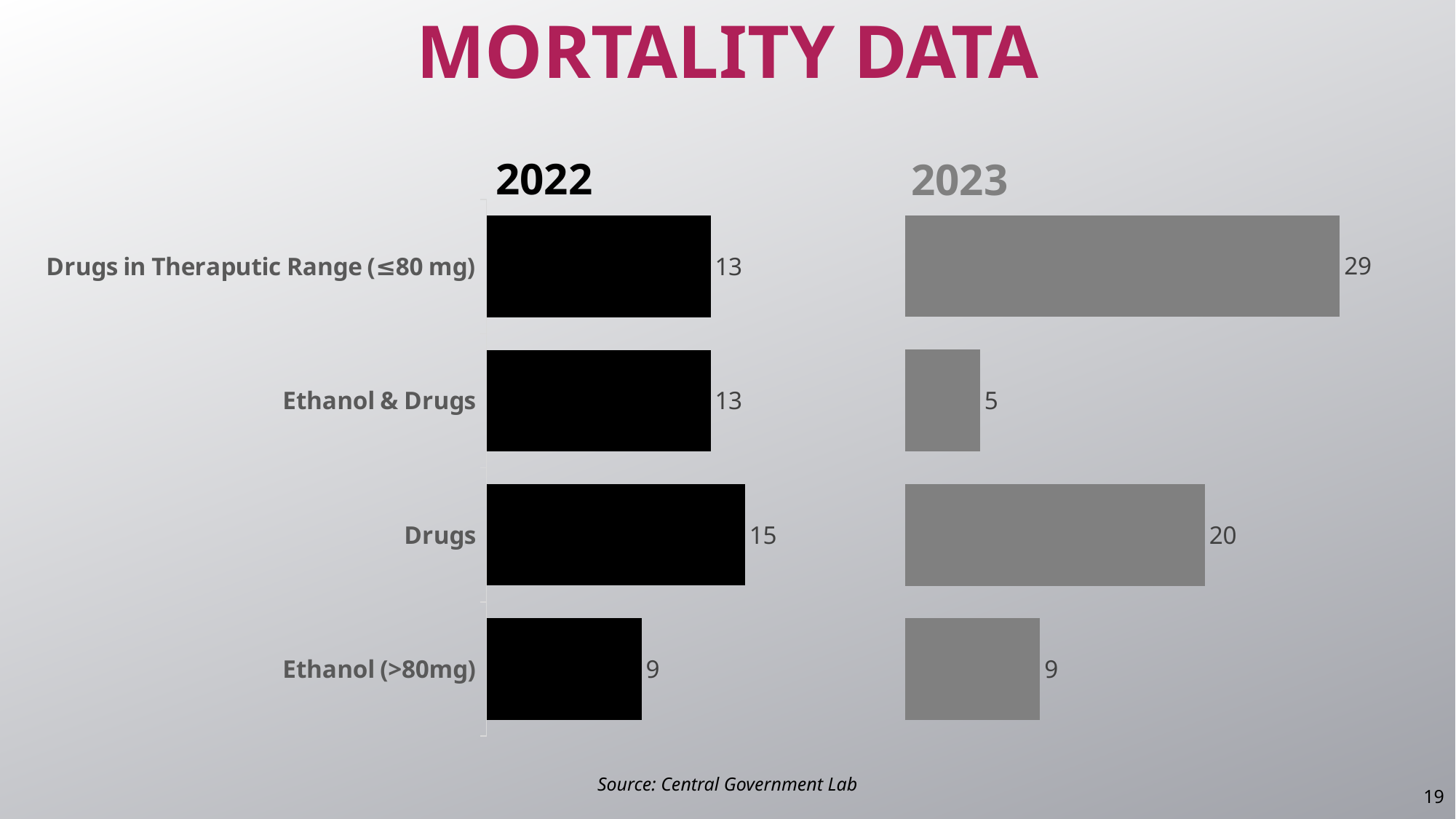
What type of chart is shown on the slide? Bar chart What is the 2022 value for Drugs? 15 How many categories are shown in the chart? 4 Which category has the lowest value in 2023? Ethanol & Drugs By how much did the value for Drugs in Theraputic Range (≤80 mg) increase from 2022 to 2023? 16 How many series (years) does the chart show? 2 What is the 2023 value for Drugs in Theraputic Range (≤80 mg)? 29 What is the 2023 value for Ethanol & Drugs? 5 For Ethanol & Drugs, which year has the larger value, 2022 or 2023? 2022 Which category has the highest value in 2022? Drugs Which category has the highest value in 2023? Drugs in Theraputic Range (≤80 mg) Which category has the lowest value in 2022? Ethanol (>80mg)